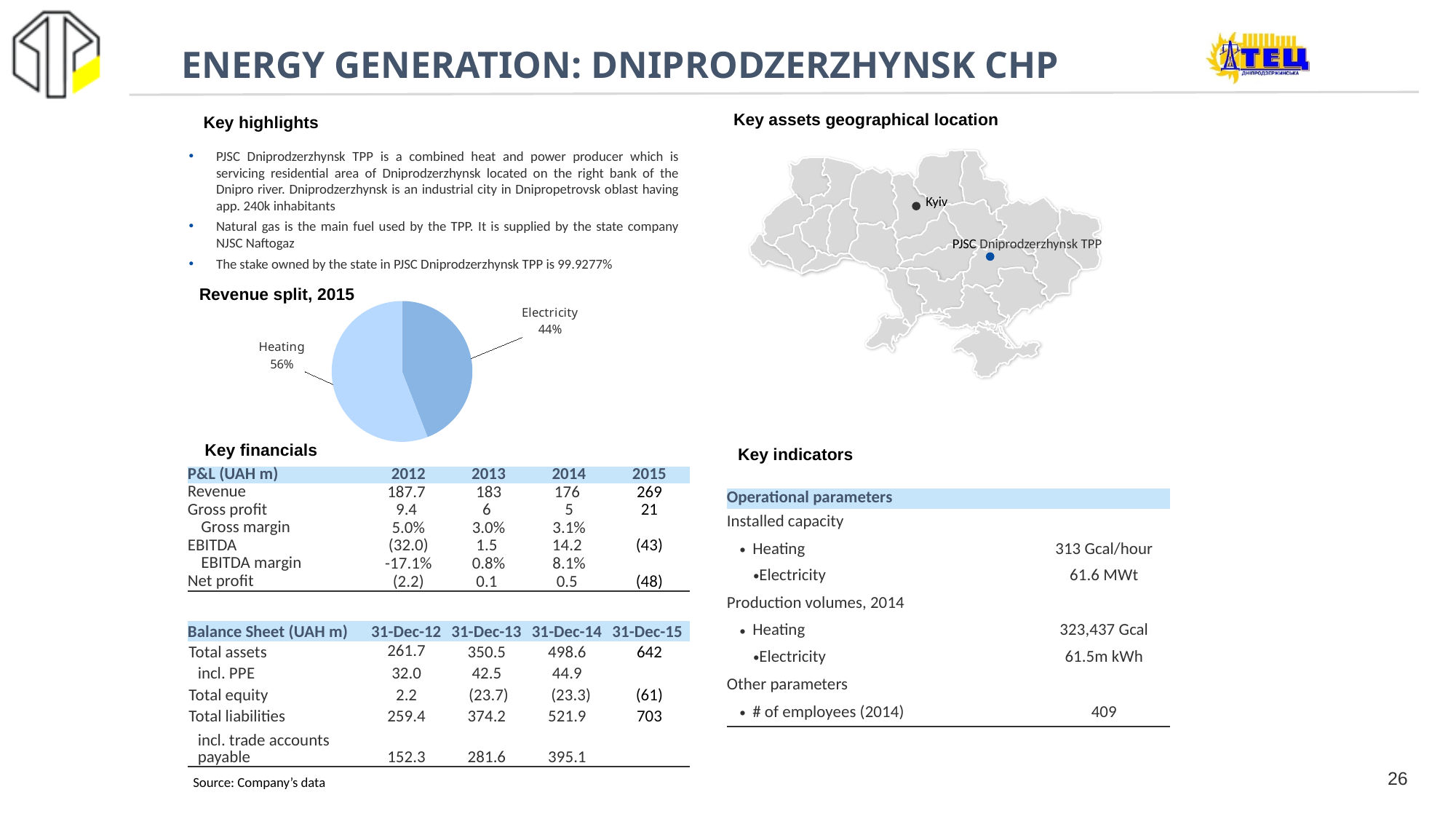
How many segments does the "Revenue split, 2015" pie chart have? 2 In the "Revenue split, 2015" pie chart, what share of revenue comes from Heating? 56% In the "Revenue split, 2015" pie chart, is the Heating share greater or less than 50%? greater In the "Revenue split, 2015" pie chart, what share of revenue comes from Electricity? 44% In the "Revenue split, 2015" pie chart, which segment has the largest share? Heating What kind of chart is the "Revenue split, 2015" chart? pie chart In the "Revenue split, 2015" pie chart, by how many percentage points does the Heating share exceed the Electricity share? 12 percentage points In the "Revenue split, 2015" pie chart, what is the Electricity slice's share of the pie? 44% In the "Revenue split, 2015" pie chart, which segment has the smallest share? Electricity What is the title of the pie chart on the slide? Revenue split, 2015 In the "Revenue split, 2015" pie chart, which is larger: the Heating share or the Electricity share? Heating